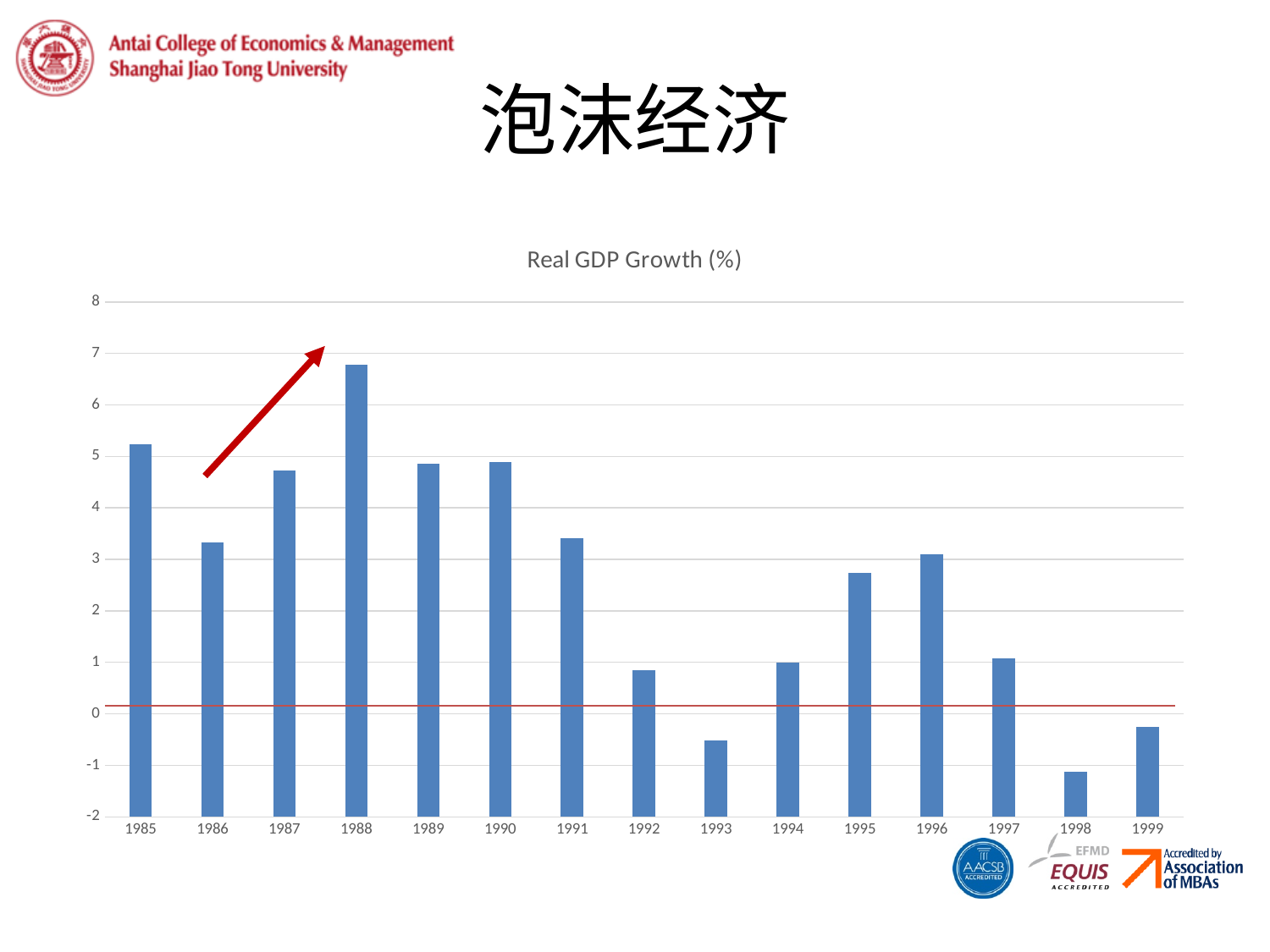
Which year has the lowest real GDP growth in the chart? 1998 Is the value for 1995 greater or less than 3? less Is the value for 1998 greater or less than -1? less How many years are plotted on the x axis of the chart? 15 Is the value for 1988 greater or less than 6? greater Which year has the larger real GDP growth, 1985 or 1986? 1985 What is the title of the chart? Real GDP Growth (%) Which year has the highest real GDP growth in the chart? 1988 Do the values rise or fall from 1988 to 1993? fall What kind of chart is shown on the slide? bar chart